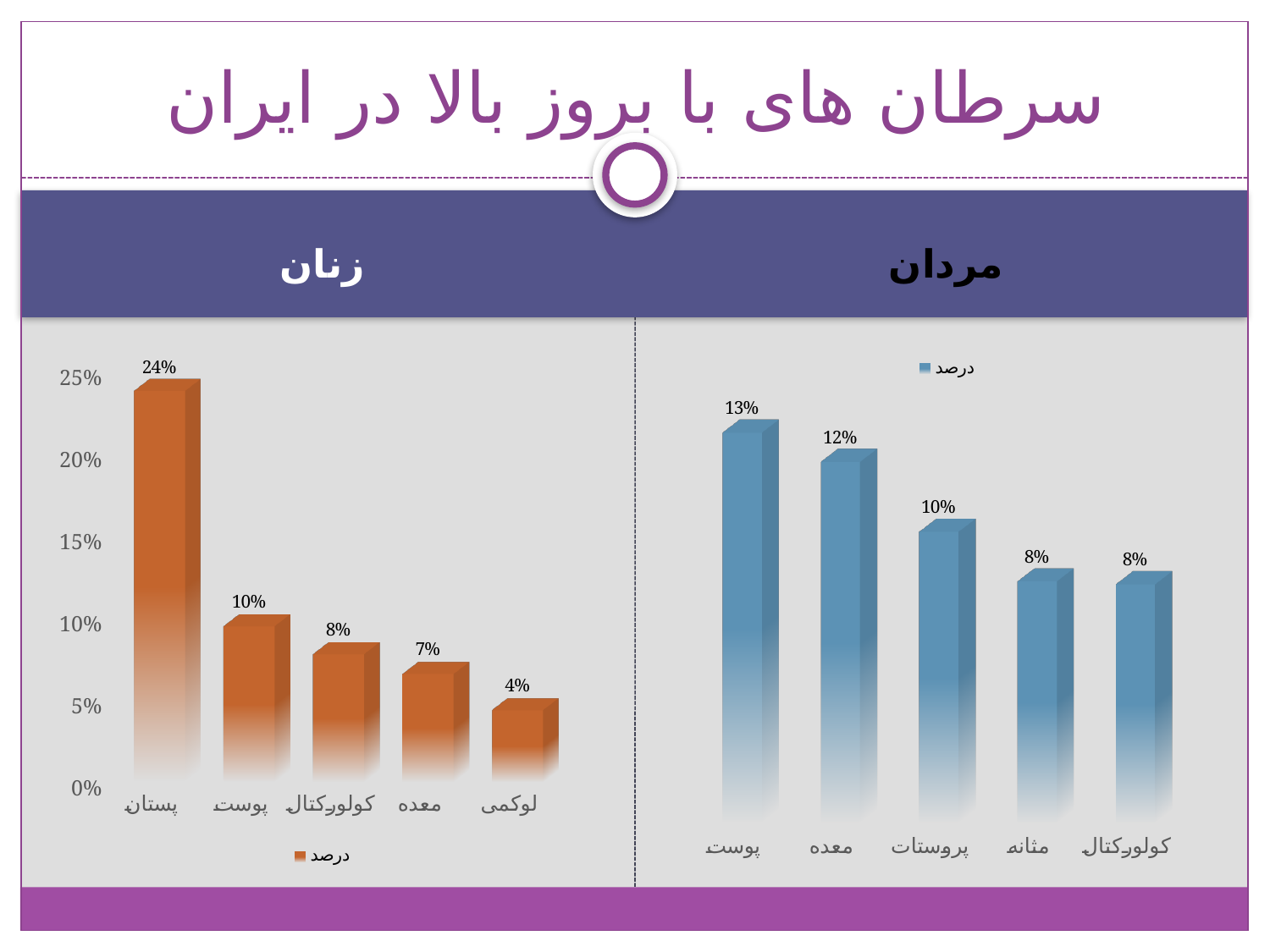
In the right chart (مردان), what is the difference between the values for پوست and مثانه? 5% In the right chart (مردان), do the values rise or fall from left to right along the x axis? fall In the right chart (مردان), what is the value for پروستات? 10% What kind of chart is the left chart (زنان)? bar chart Which is larger: the value for پوست in the left chart (زنان) or the value for پوست in the right chart (مردان)? پوست in the right chart (مردان) What is the legend entry shown in the right chart (مردان)? درصد In the left chart (زنان), is the value for پستان greater or less than 20%? greater In the left chart (زنان), which category has the lowest value? لوکمی How many categories are shown in the right chart (مردان)? 5 In the right chart (مردان), which category has the highest value? پوست In the left chart (زنان), what is the difference between the values for پستان and پوست? 14% In the left chart (زنان), what is the value for پستان? 24%